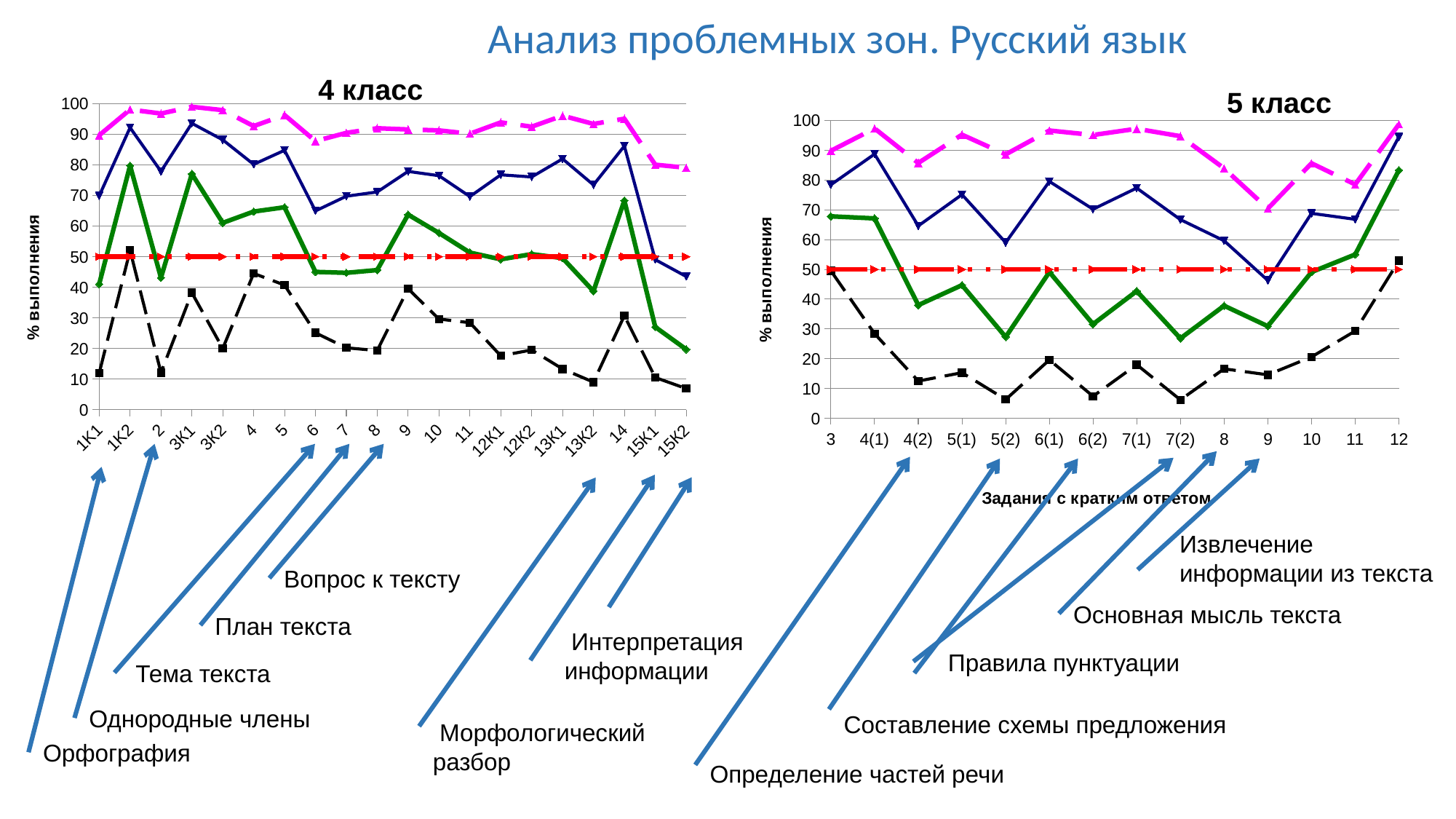
In the "5 класс" chart, at what value does the flat red dashed line run? 50 In the "4 класс" chart, is the value of the magenta dashed line at 3К1 greater or less than 90? greater In the "5 класс" chart, is the value of the green line at 5(2) greater or less than 30? less What kind of chart is the "4 класс" chart? line chart How many categories are shown on the x axis of the "5 класс" chart? 14 How many categories are shown on the x axis of the "4 класс" chart? 20 In the "4 класс" chart, at which category does the black dashed line reach its highest value? 1К2 In the "4 класс" chart, is the value of the black dashed line at 1К1 greater or less than 20? less What is the label of the vertical axis on both charts? % выполнения In the "5 класс" chart, at which category does the green line reach its highest value? 12 In the "4 класс" chart, at what value does the flat red dashed line run? 50